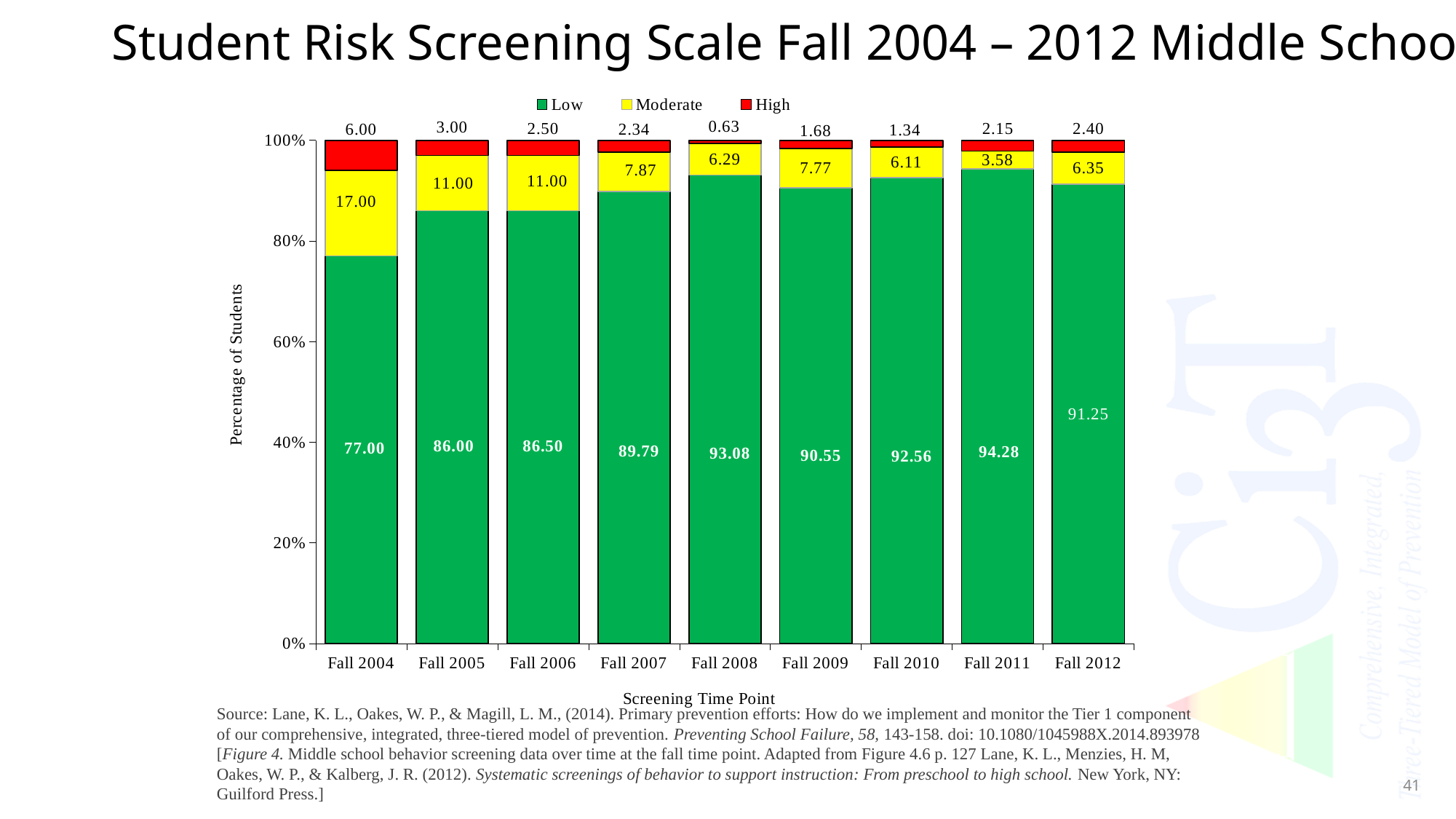
What percentage of students were in the Low risk category in Fall 2004? 77.00 Which screening time point has the highest Low value? Fall 2011 How many series does the legend list? 3 What is the Moderate value for Fall 2007? 7.87 What is the difference between the Low value in Fall 2011 and the Low value in Fall 2004? 17.28 How many screening time points are shown on the x axis? 9 Which screening time point has the highest Moderate value? Fall 2004 What kind of chart is shown on the slide? Stacked bar chart What is the High value for Fall 2008? 0.63 Which is larger, the Moderate value for Fall 2009 or the Moderate value for Fall 2010? Fall 2009 Which screening time point has the lowest High value? Fall 2008 What is the total of the stacked bar for Fall 2004? 100.00